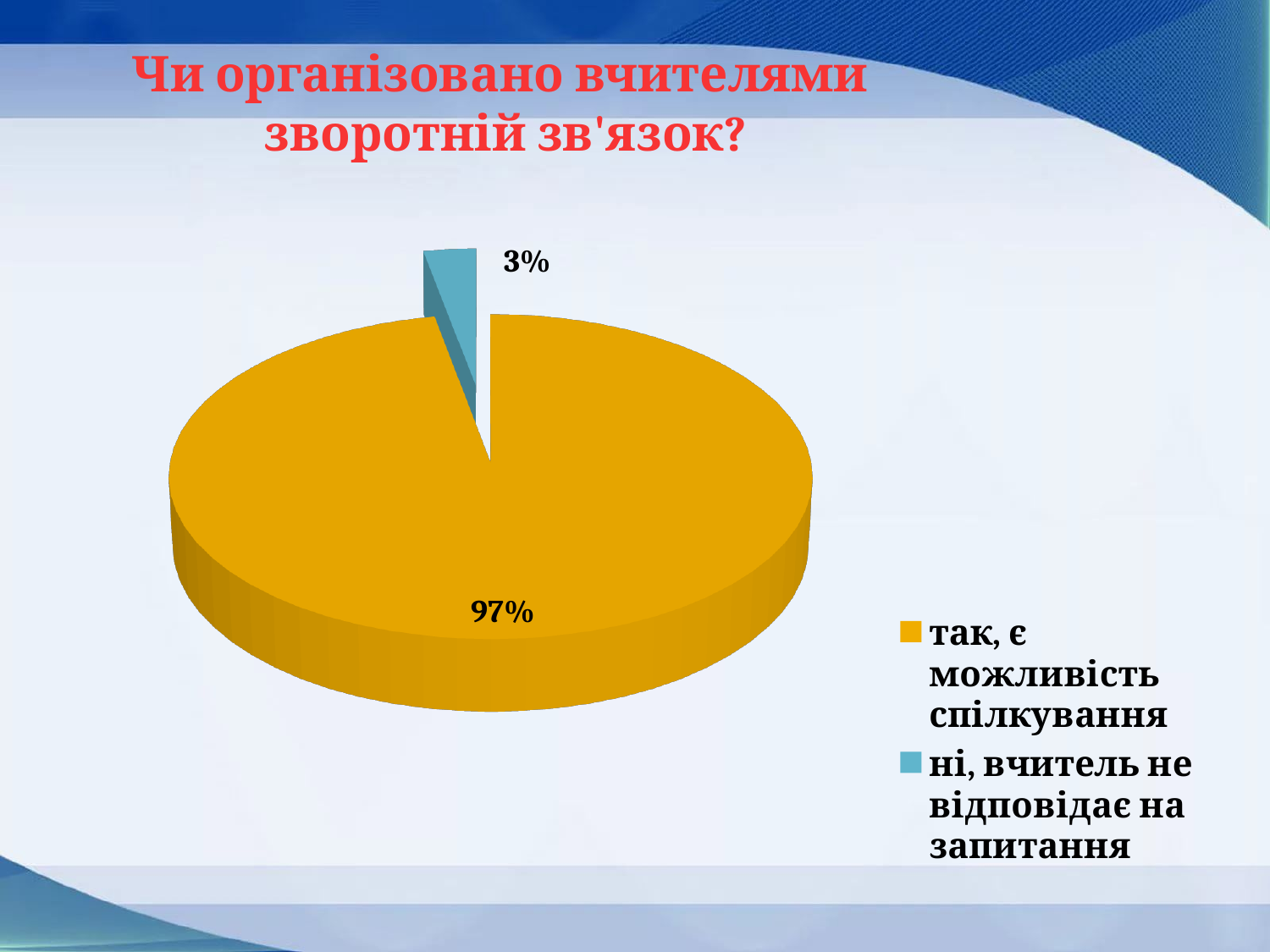
What share of the pie is labelled "ні, вчитель не відповідає на запитання"? 3% How many entries does the legend list? 2 Which is larger: the "так, є можливість спілкування" slice or the "ні, вчитель не відповідає на запитання" slice? так, є можливість спілкування What is the difference in percentage points between the "так, є можливість спілкування" slice and the "ні, вчитель не відповідає на запитання" slice? 94 What colour is the slice for "ні, вчитель не відповідає на запитання"? blue What share of the pie is labelled "так, є можливість спілкування"? 97% Which category has the smallest slice of the pie? ні, вчитель не відповідає на запитання What is the title of the chart on the slide? Чи організовано вчителями зворотній зв'язок? Which category has the largest slice of the pie? так, є можливість спілкування What is the total of the two percentages shown on the pie chart? 100% What kind of chart is shown on the slide? pie chart How many slices does the pie chart have? 2